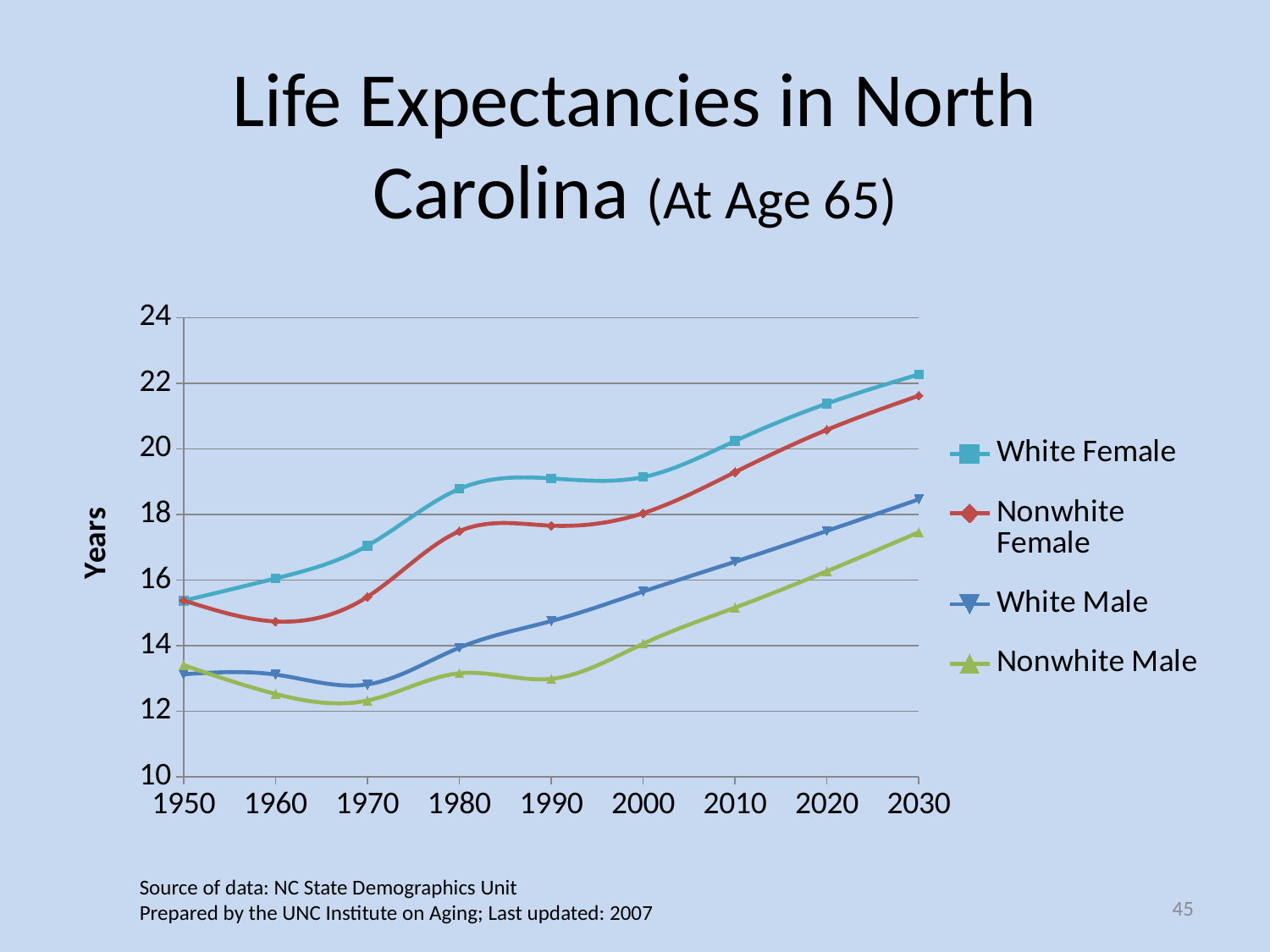
Is the value for Nonwhite Male in 1970 greater or less than 14? less What is the label on the y axis? Years What kind of chart is shown on the slide? line chart How many series does the legend list? 4 Is the value for White Female in 2030 greater or less than 20? greater Does the Nonwhite Male line rise or fall between 1950 and 1970? falls How many years are marked along the x axis? 9 In 2000, which is larger: the value for White Female or the value for White Male? White Female Does the White Female line rise or fall from 1950 to 2030? rises Which series has the lowest value in 1970? Nonwhite Male Which series has the highest value in 2030? White Female Is the value for Nonwhite Female in 2010 greater or less than 18? greater